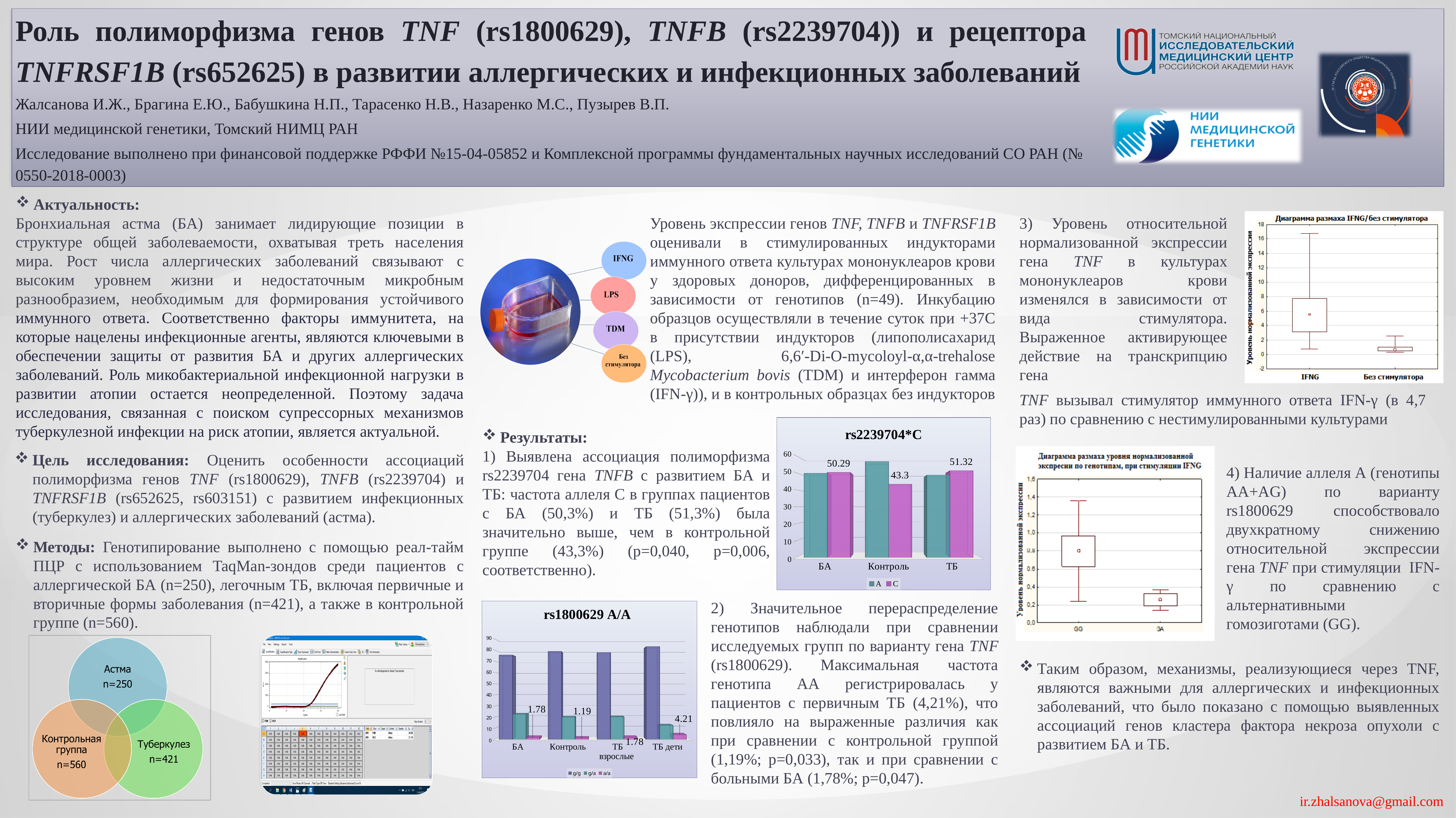
In the chart titled rs1800629 A/A, how many categories are shown on the x axis? 4 In the chart titled rs1800629 A/A, what is the labelled a/a value for ТБ дети? 4.21 In the chart titled rs2239704*C, how many series does the legend list? 2 In the chart titled rs2239704*C, is the value for the A series in the Контроль group greater or less than 50? greater In the box plot titled Диаграмма размаха IFNG/без стимулятора, which of the two categories shows the higher expression level? IFNG In the chart titled rs1800629 A/A, is the g/g value for ТБ дети greater or less than 80? greater In the chart titled rs2239704*C, what is the difference between the labelled C values for ТБ and Контроль? 8.02 What kind of chart is the one titled rs1800629 A/A? bar chart In the chart titled rs1800629 A/A, which group has the highest labelled a/a value? ТБ дети In the chart titled rs2239704*C, what is the labelled value for the C series in the Контроль group? 43.3 In the chart titled rs2239704*C, what is the labelled value for the C series in the ТБ group? 51.32 In the chart titled rs2239704*C, which group has the lowest labelled C value? Контроль